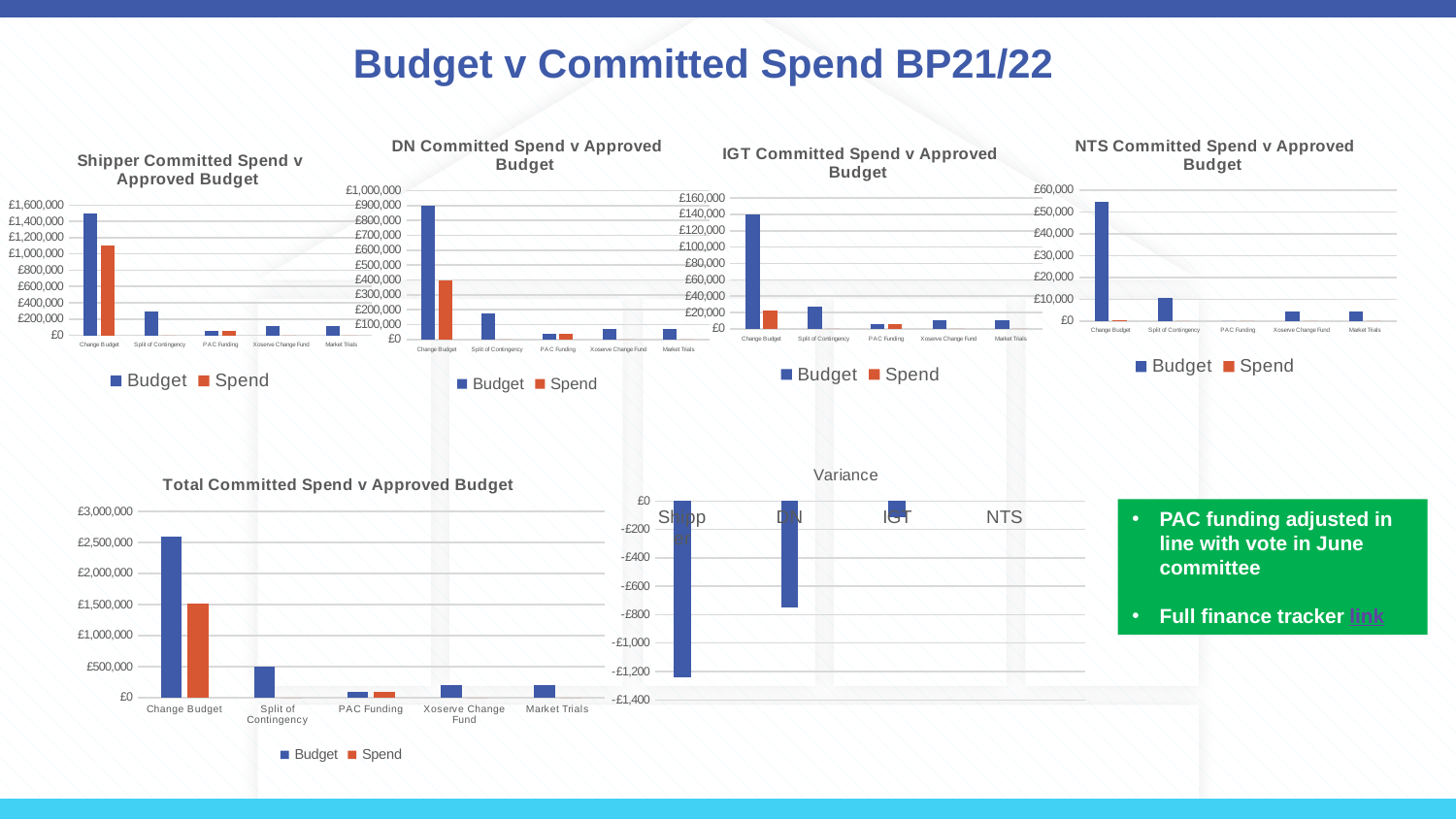
In the 'IGT Committed Spend v Approved Budget' chart, is the Budget value for Change Budget greater or less than £120,000? greater In the 'Shipper Committed Spend v Approved Budget' chart, is the Budget value for Change Budget greater or less than £1,400,000? greater In the 'DN Committed Spend v Approved Budget' chart, is the Budget value for Change Budget greater or less than £800,000? greater How many categories are shown on the x axis of the 'Total Committed Spend v Approved Budget' chart? 5 What kind of chart is the 'Shipper Committed Spend v Approved Budget' chart? bar chart In the 'Total Committed Spend v Approved Budget' chart, which category has the highest Budget value? Change Budget In the 'Variance' chart, which category has the lowest (most negative) value? Shipper How many series does the legend of the 'Total Committed Spend v Approved Budget' chart list? 2 In the 'Shipper Committed Spend v Approved Budget' chart, for Change Budget, which is larger: Budget or Spend? Budget